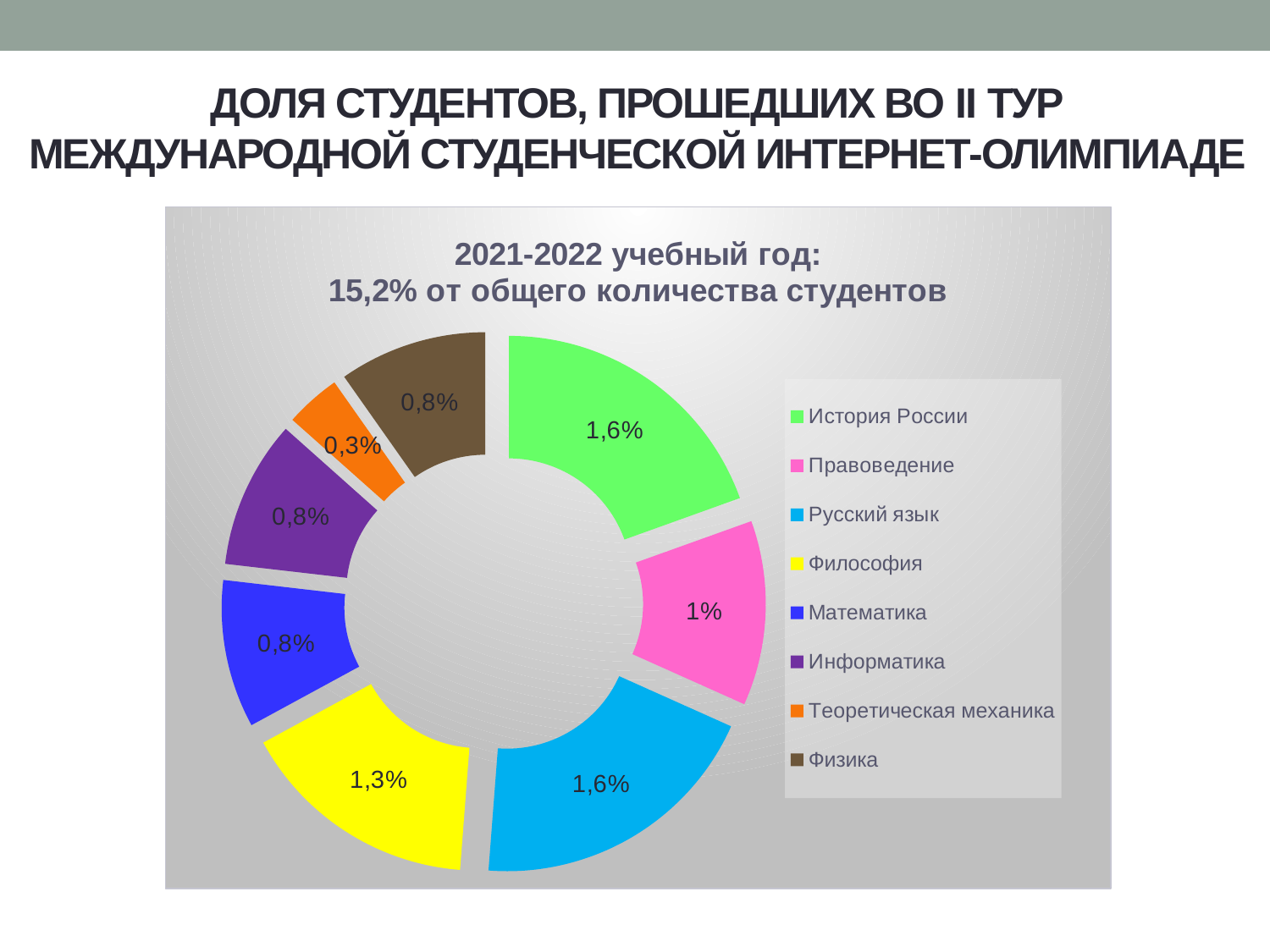
What is the value shown for Философия? 1,3% Which category has the lowest value in the chart? Теоретическая механика What is the difference between the values for Философия and Правоведение? 0,3% What is the value shown for Правоведение? 1% How many categories does the chart show? 8 What kind of chart is shown on the slide? doughnut chart Which is larger, the value for Философия or the value for Математика? Философия What is the value shown for История России? 1,6% What is the difference between the values for Русский язык and Физика? 0,8% What is the value shown for Теоретическая механика? 0,3% What is the value shown for Математика? 0,8% What is the title of the chart? 2021-2022 учебный год: 15,2% от общего количества студентов